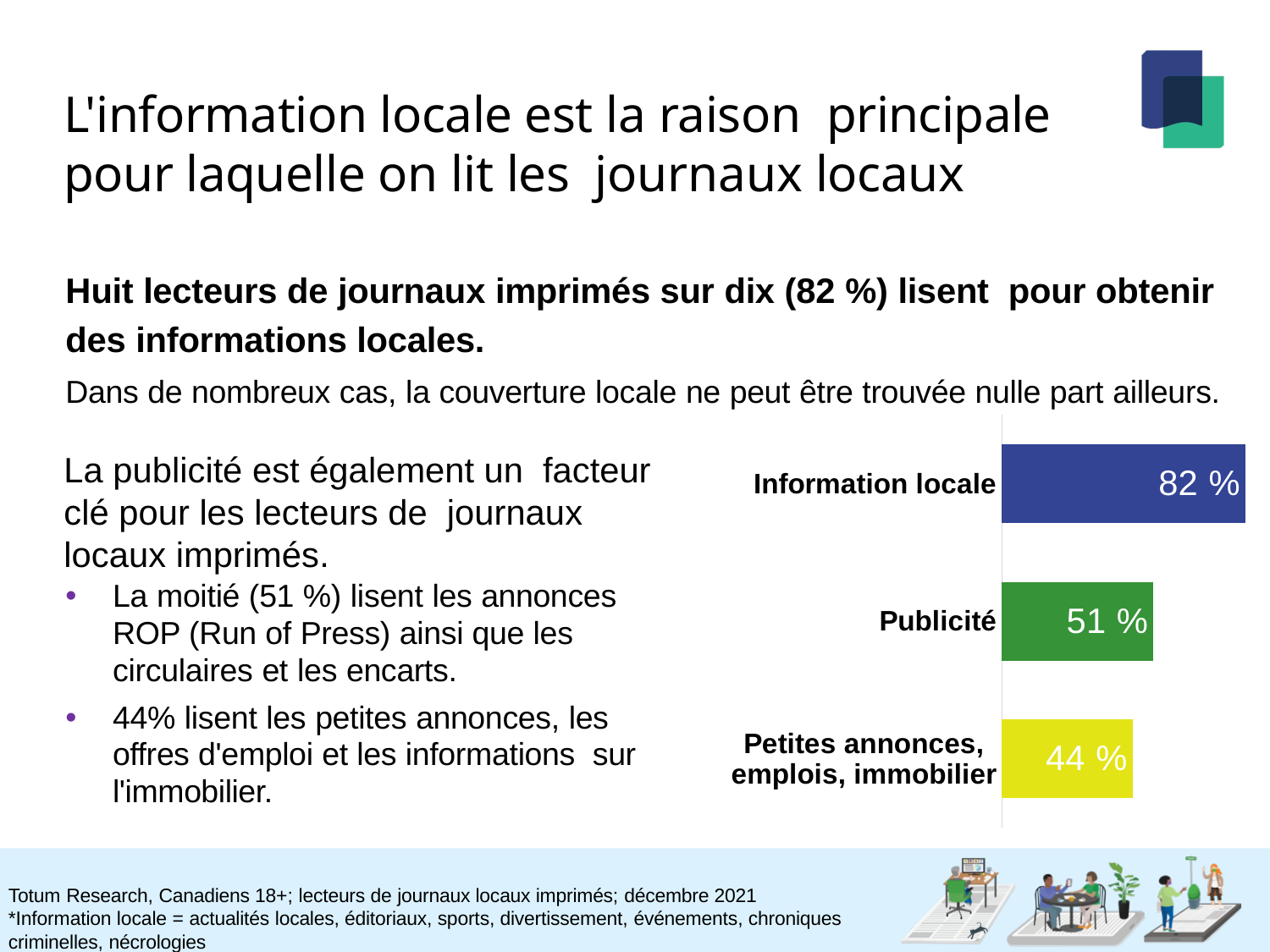
Which is larger, the value for Publicité or the value for Petites annonces, emplois, immobilier? Publicité How many categories are shown in the chart? 3 What kind of chart is shown on the slide? bar chart What is the difference between the values for Information locale and Publicité? 31 % What is the difference between the values for Publicité and Petites annonces, emplois, immobilier? 7 % What is the value for Information locale? 82 % What is the value for Petites annonces, emplois, immobilier? 44 % What colour is the bar for Information locale? blue Which category has the highest value? Information locale What colour is the bar for Petites annonces, emplois, immobilier? yellow Which category has the lowest value? Petites annonces, emplois, immobilier What is the value for Publicité? 51 %